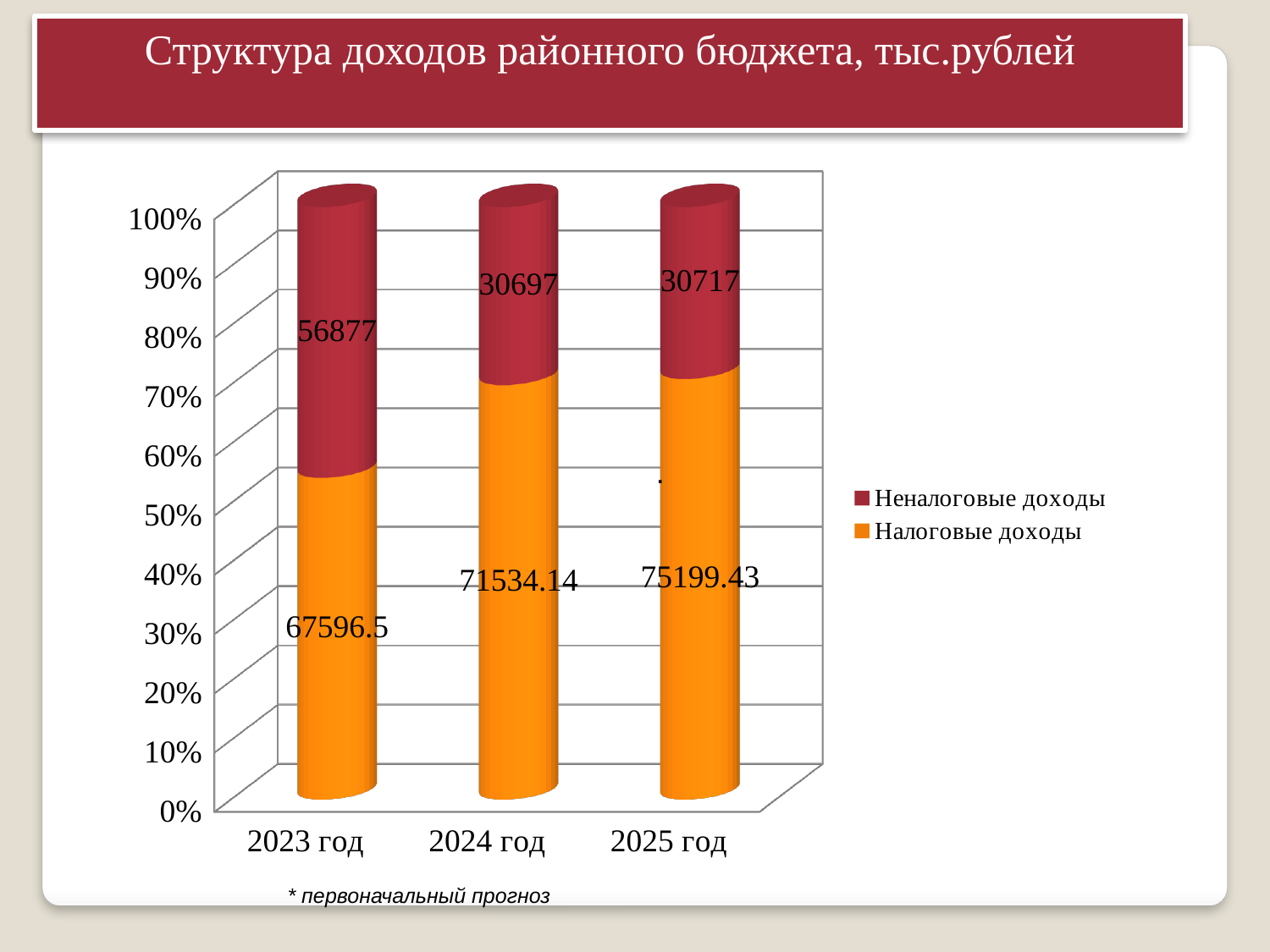
What is the difference between Налоговые доходы and Неналоговые доходы in 2023 год? 10719.5 What is the value of Неналоговые доходы for 2023 год? 56877 What is the difference between Налоговые доходы in 2025 год and 2024 год? 3665.29 What is the total of the stacked bar for 2025 год? 105916.43 Which is larger in 2024 год: Налоговые доходы or Неналоговые доходы? Налоговые доходы What is the value of Налоговые доходы for 2023 год? 67596.5 How many series does the legend list? 2 In which year is Неналоговые доходы highest? 2023 год What is the title of the chart? Структура доходов районного бюджета, тыс.рублей What is the value of Неналоговые доходы for 2024 год? 30697 What is the value of Налоговые доходы for 2025 год? 75199.43 In which year is Налоговые доходы lowest? 2023 год